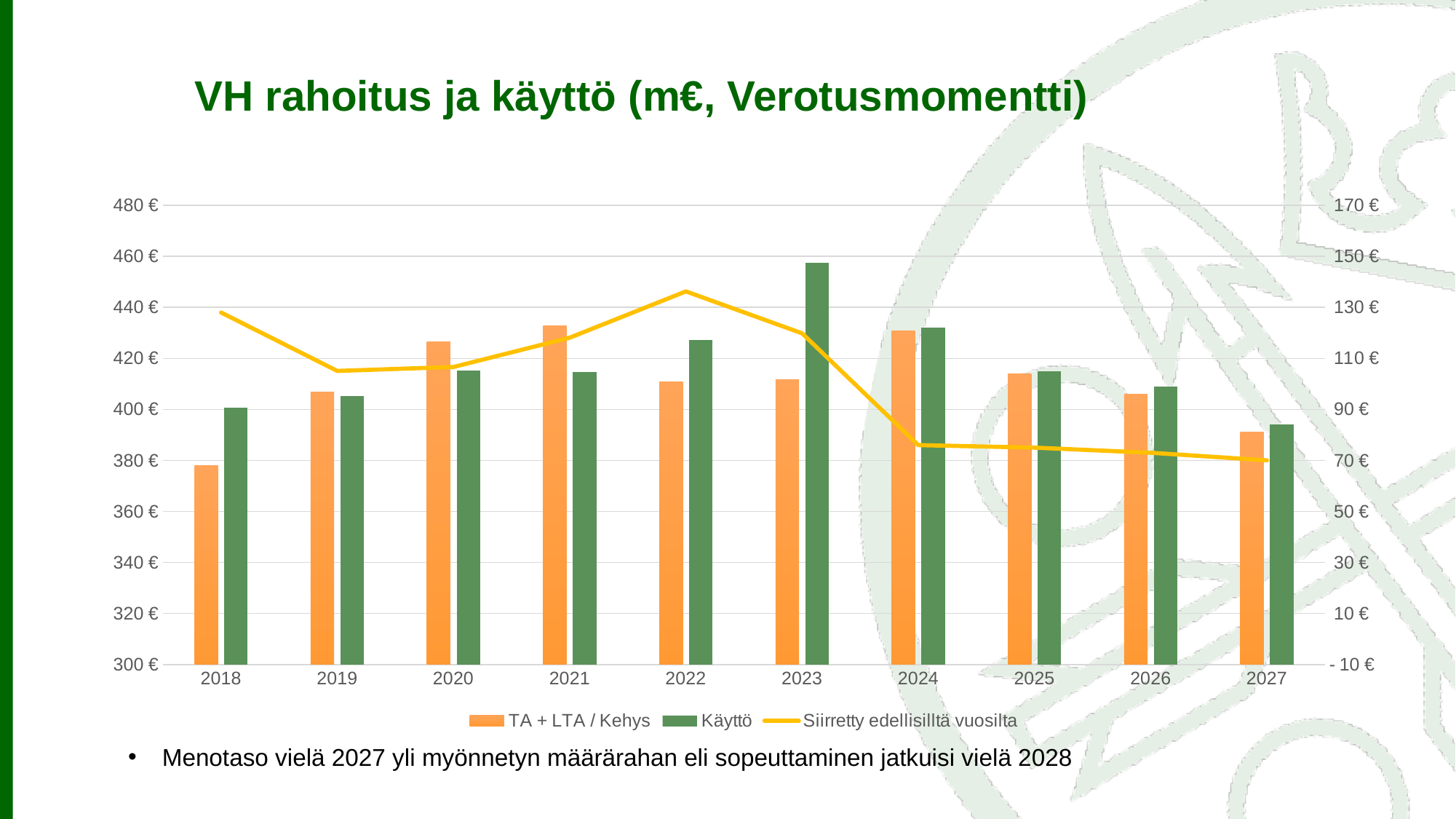
What is the title of the chart? VH rahoitus ja käyttö (m€, Verotusmomentti) Is the Käyttö value for 2023 greater or less than 440 €? greater How many series does the legend list? 3 Does the Siirretty edellisiltä vuosilta line rise or fall from 2023 to 2027? fall Is the TA + LTA / Kehys value for 2018 greater or less than 400 €? less In 2022, which is larger: TA + LTA / Kehys or Käyttö? Käyttö In which year is the Käyttö bar highest? 2023 How many years are shown on the x axis? 10 In which year does the Siirretty edellisiltä vuosilta line reach its highest point? 2022 In which year is the TA + LTA / Kehys bar lowest? 2018 What kind of chart is this? combination bar and line chart Which series is drawn as a line rather than bars? Siirretty edellisilltä vuosilta